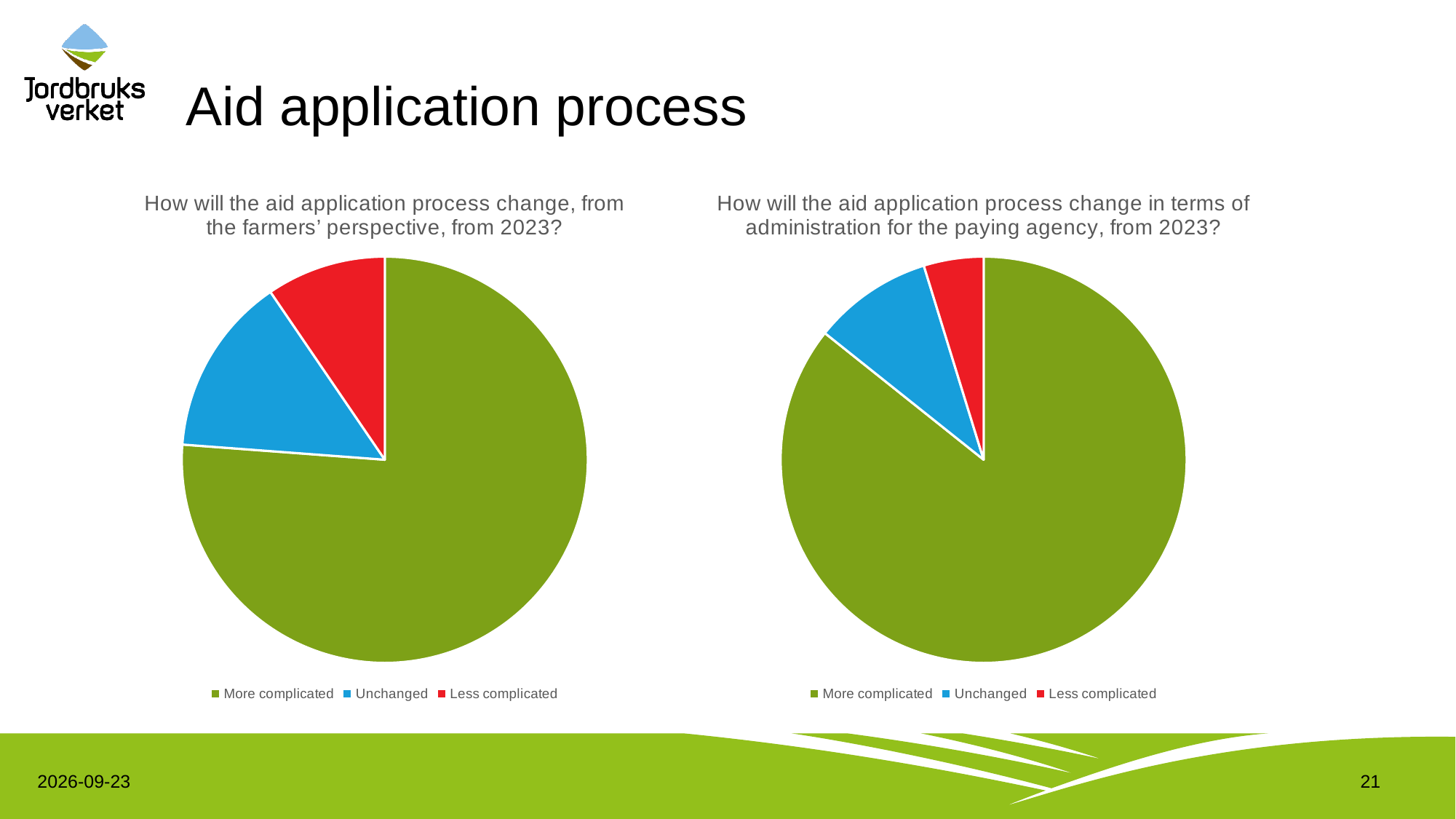
How many slices does the right chart (paying agency administration) have? 3 In the right chart (paying agency administration), which category has the smallest slice? Less complicated In the left chart (farmers' perspective), which slice is larger: Unchanged or Less complicated? Unchanged In the left chart (farmers' perspective), which category has the smallest slice? Less complicated In the left chart (farmers' perspective), which category has the largest slice? More complicated What kind of chart is the right chart, about administration for the paying agency? Pie chart Is the Less complicated slice larger in the left chart (farmers' perspective) or in the right chart (paying agency administration)? Left chart In the right chart (paying agency administration), which slice is larger: Unchanged or Less complicated? Unchanged In the right chart (paying agency administration), which category has the largest slice? More complicated What kind of chart is the left chart, titled "How will the aid application process change, from the farmers' perspective, from 2023?"? Pie chart In the right chart (paying agency administration), what colour is the Unchanged slice? Blue How many categories does the legend of the left chart (farmers' perspective) list? 3